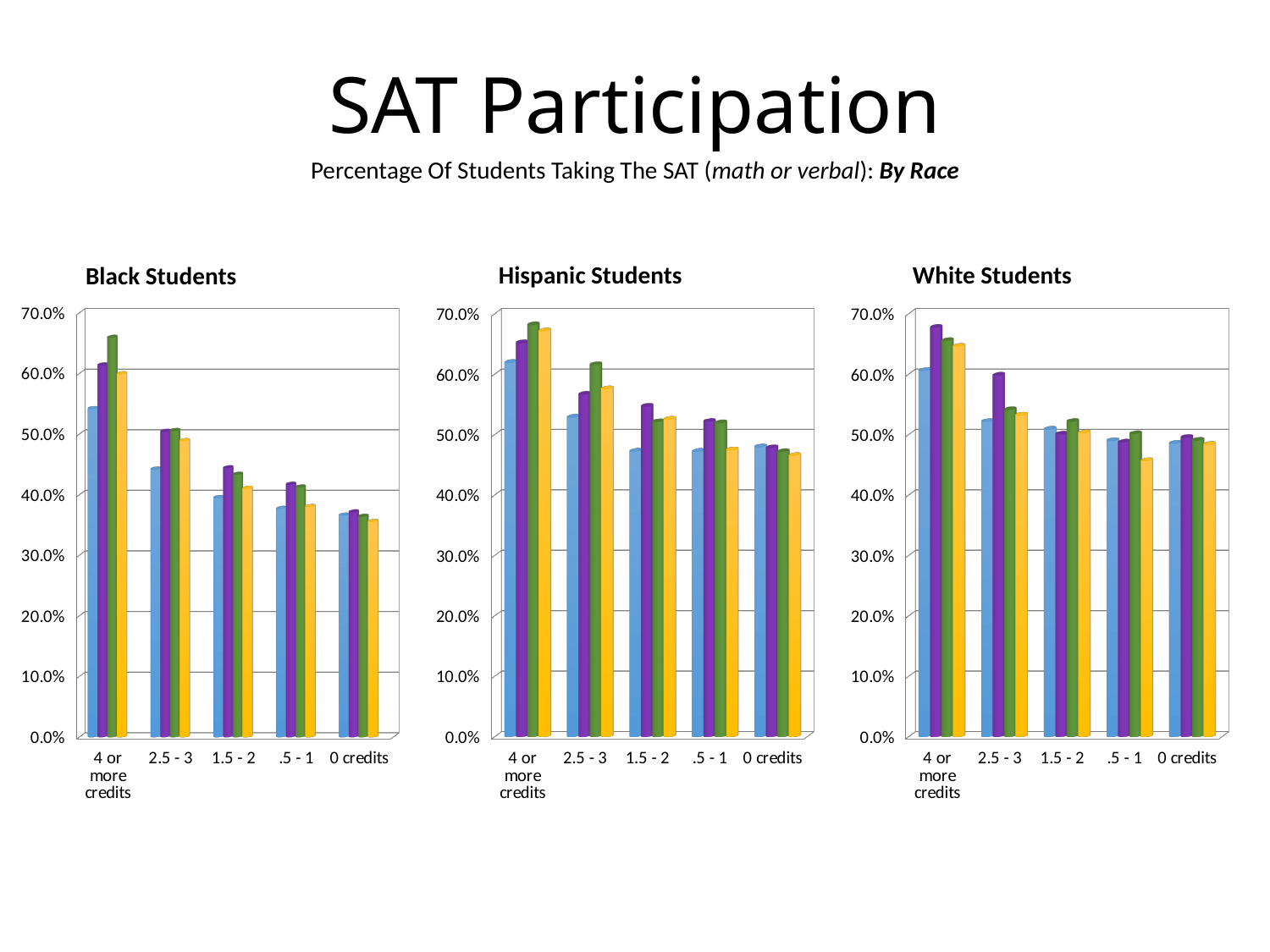
In the Hispanic Students chart, which credit category has the tallest bars? 4 or more credits In the White Students chart, do the bar values generally rise or fall moving from 4 or more credits to 0 credits? fall What are the titles of the three charts on the slide? Black Students, Hispanic Students, White Students In the Black Students chart, which credit category has the tallest bars? 4 or more credits How many credit categories are shown on the x axis of the Hispanic Students chart? 5 In the Black Students chart, is the value of the blue bar for 0 credits greater or less than 40.0%? less What kind of chart is the Black Students chart? bar chart In the Black Students chart, which credit category has the shortest bars? 0 credits In the Hispanic Students chart, is the value of the yellow bar for 0 credits greater or less than 50.0%? less In the Black Students chart, is the value of the green bar for 4 or more credits greater or less than 60.0%? greater How many bars are plotted for each credit category in the White Students chart? 4